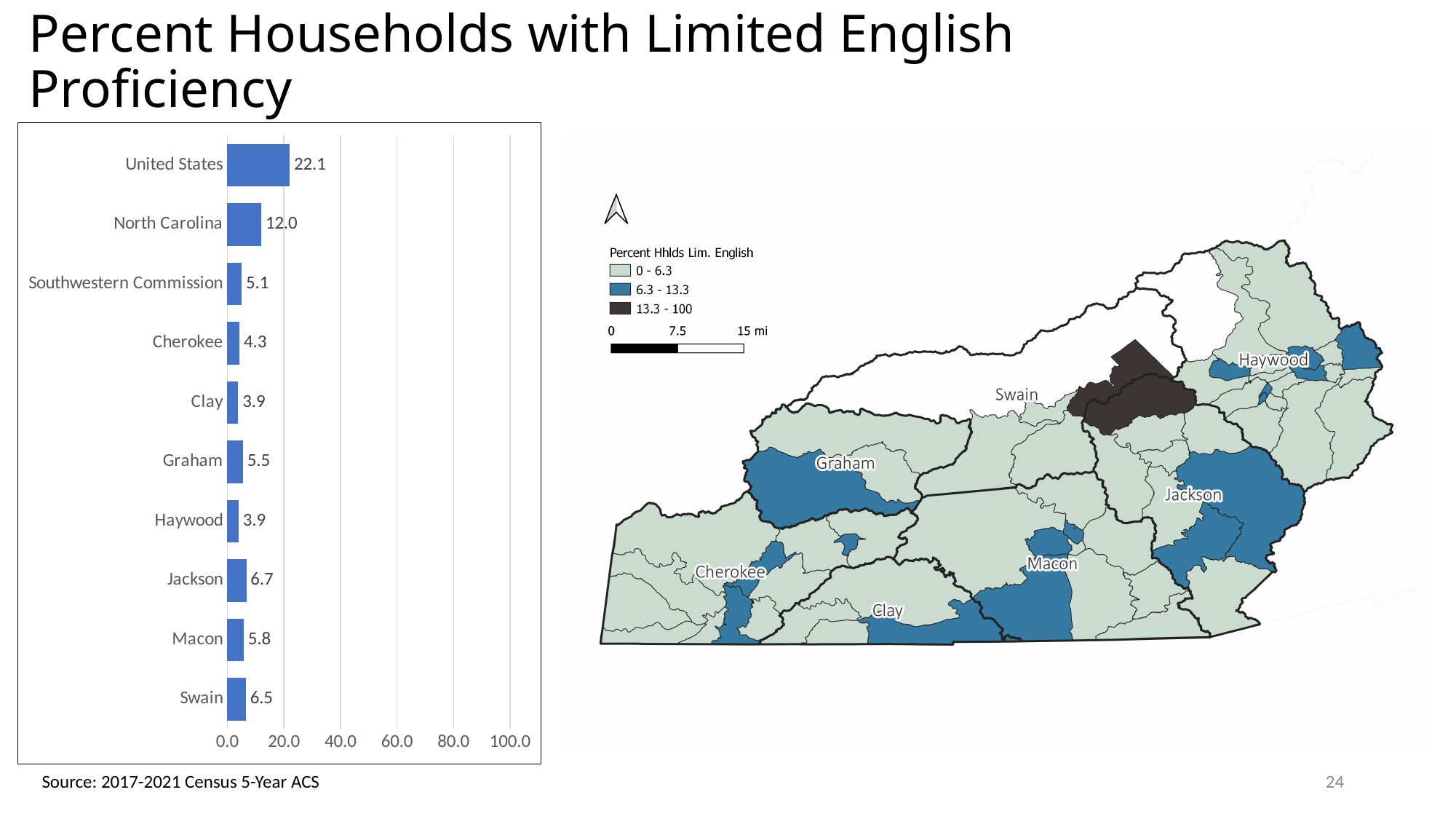
What is the difference between the United States and North Carolina values in the bar chart? 10.1 What is the value for North Carolina in the bar chart? 12.0 What is the value for Southwestern Commission in the bar chart? 5.1 In the bar chart, which is larger, the value for Cherokee or the value for Swain? Swain How many categories are shown in the bar chart? 10 What kind of chart is shown on the left of the slide? Bar chart In the bar chart, which is larger, the value for Macon or the value for Graham? Macon What is the difference between the Jackson and Swain values in the bar chart? 0.2 What is the value for United States in the bar chart? 22.1 What is the highest tick value shown on the x axis of the bar chart? 100.0 Which category has the highest value in the bar chart? United States What is the value for Jackson in the bar chart? 6.7